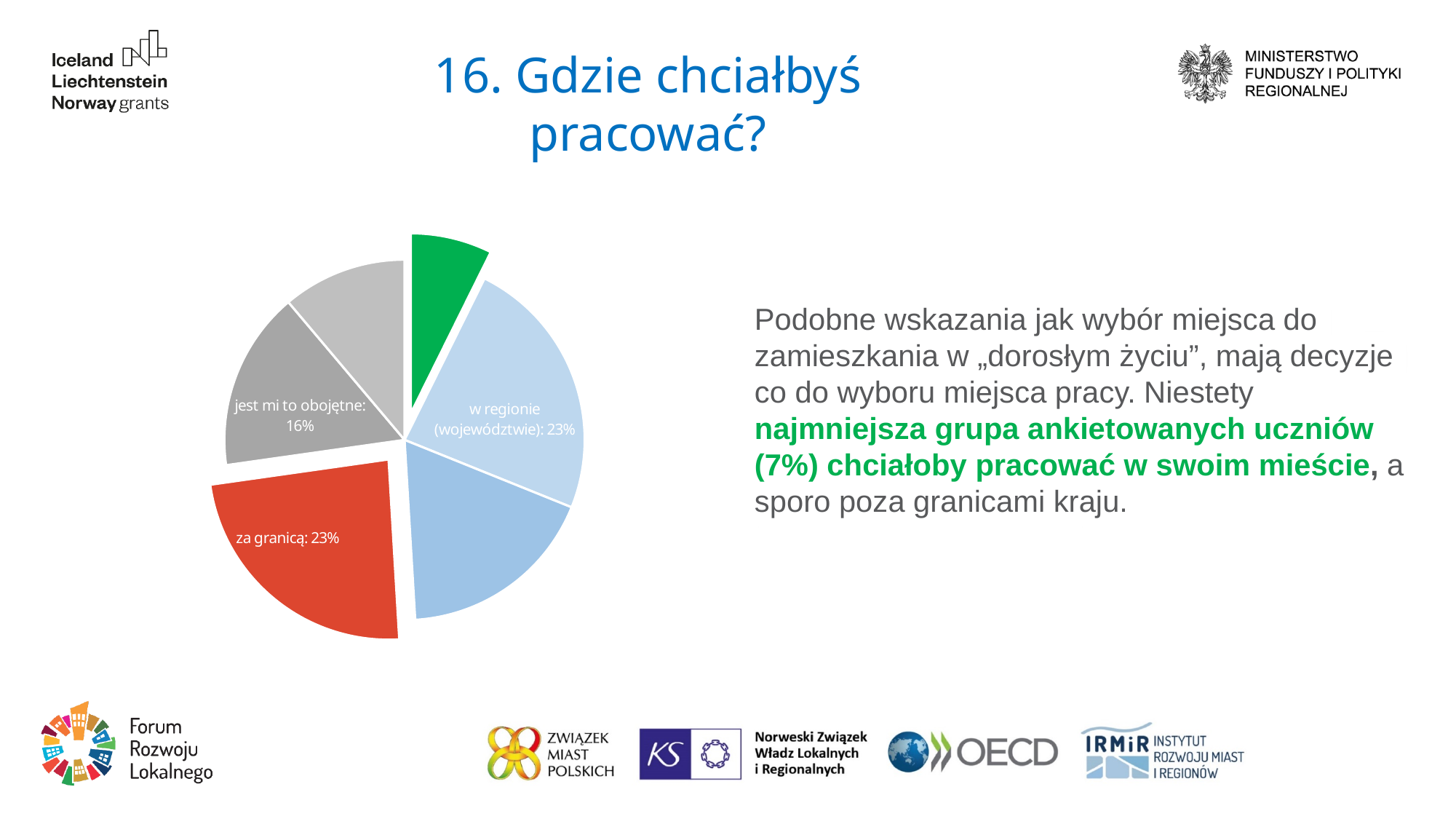
Of the slices with printed labels, which has the lowest value? jest mi to obojętne Which is larger, the "za granicą" slice or the "jest mi to obojętne" slice? za granicą What kind of chart is shown on the slide? pie chart Do the "w regionie (województwie)" and "za granicą" slices have the same value? yes, both 23% What share of the pie is labelled "w regionie (województwie)"? 23% What share of the pie is labelled "za granicą"? 23% What share of the pie is labelled "jest mi to obojętne"? 16% What colour is the "za granicą" slice of the pie chart? red What is the title of the slide containing the pie chart? 16. Gdzie chciałbyś pracować? How many slices does the pie chart have? 6 What is the difference in percentage points between the "za granicą" slice and the "jest mi to obojętne" slice? 7